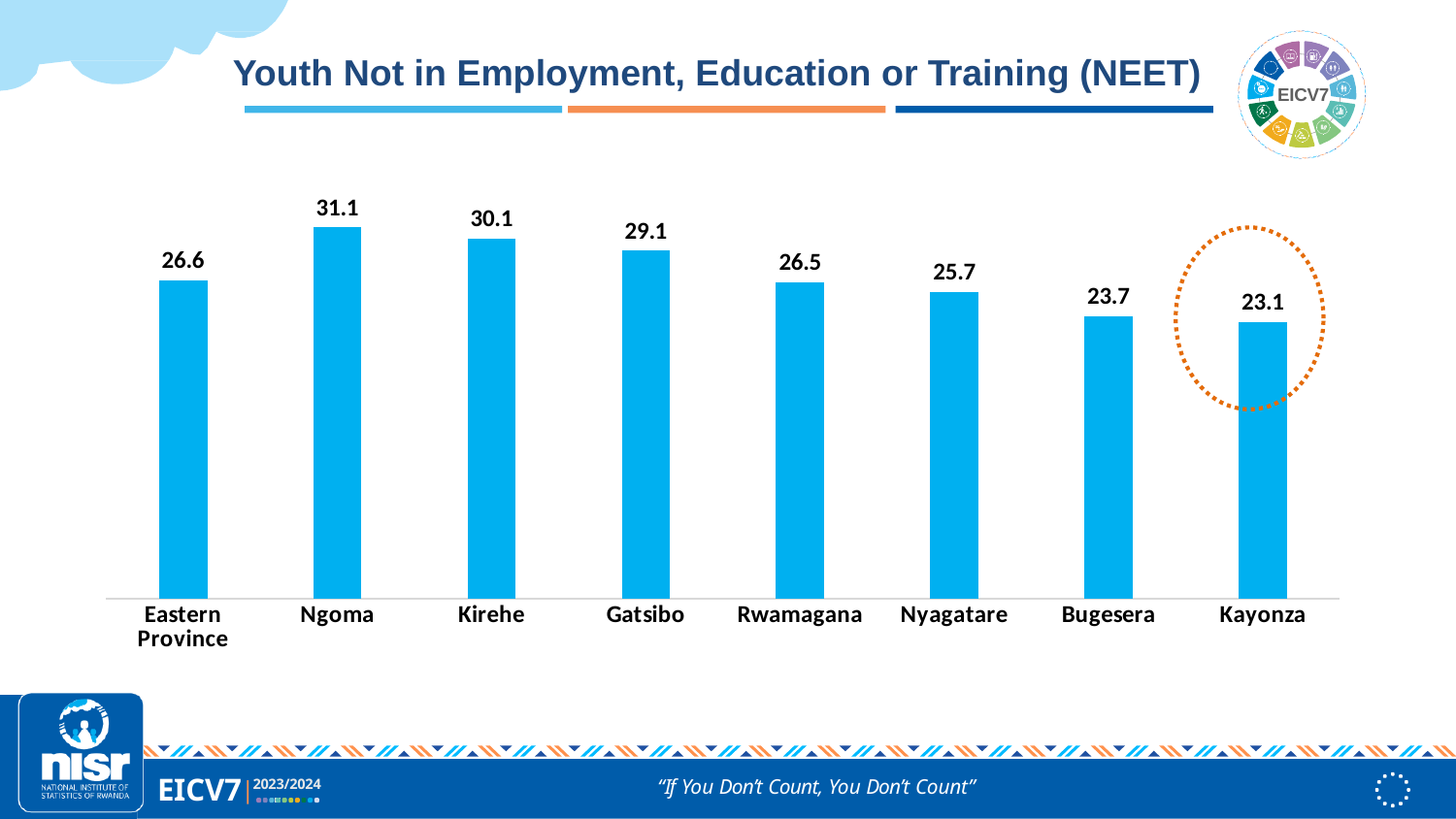
What is the difference between the NEET values for Kirehe and Gatsibo? 1.0 What is the NEET value for Ngoma? 31.1 What is the difference between the NEET values for Ngoma and Kayonza? 8.0 Do the values rise or fall from Ngoma to Kayonza along the x axis? Fall Which district has the highest NEET value? Ngoma Which has a higher NEET value, Nyagatare or Bugesera? Nyagatare What kind of chart is shown on the slide? Bar chart What is the NEET value for Eastern Province? 26.6 Which bar is highlighted with a dotted orange circle? Kayonza Which category has the lowest NEET value? Kayonza What is the NEET value for Kayonza? 23.1 How many categories are shown on the chart? 8